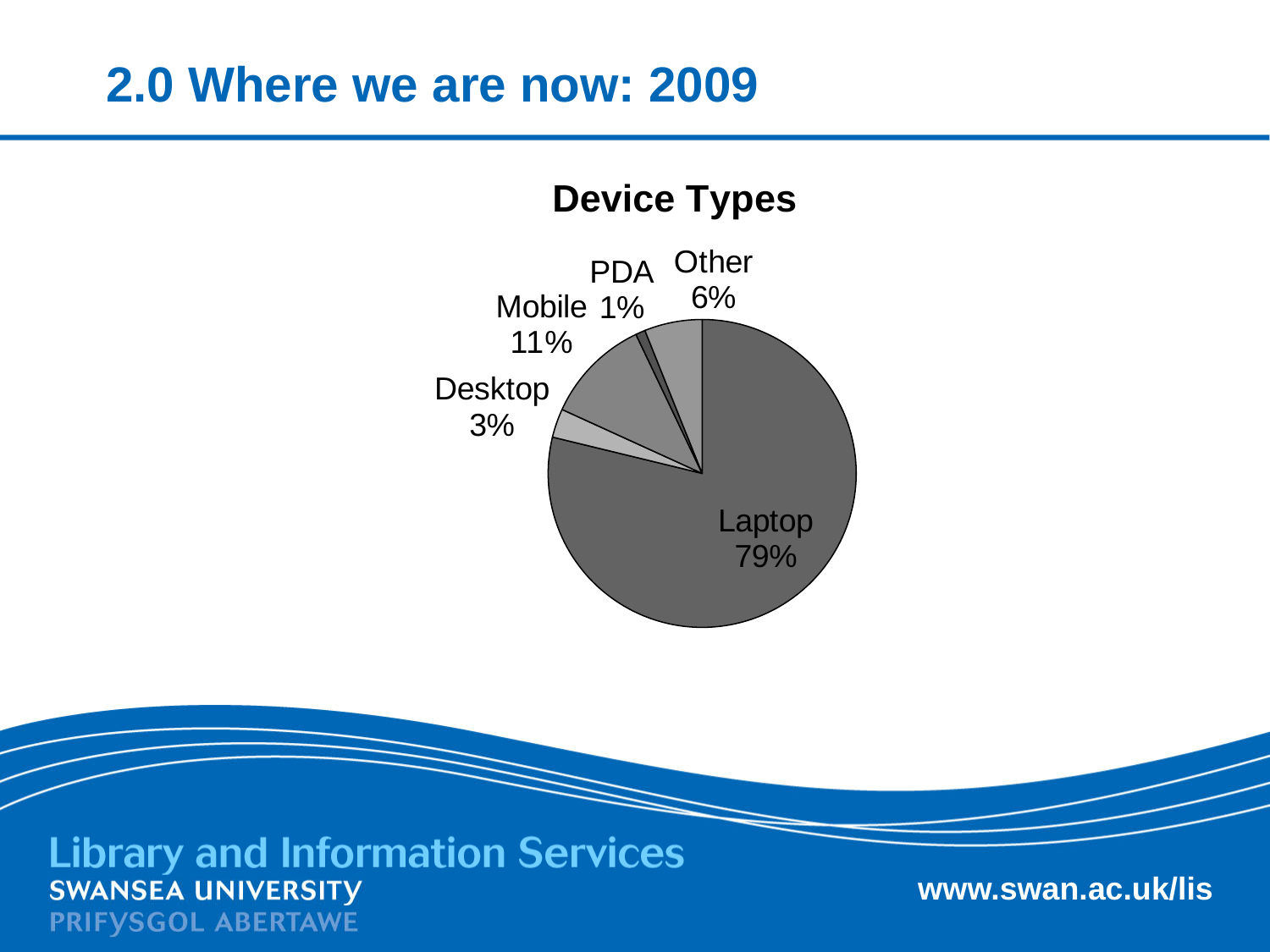
What is the difference between the Laptop and Mobile shares? 68% How many device types are shown in the pie chart? 5 What is the value shown for PDA? 1% Which device type has the largest slice? Laptop What share of the pie does Laptop account for? 79% What is the value shown for Desktop? 3% What is the title of the chart? Device Types What is the value shown for Other? 6% What kind of chart is shown on the slide? Pie chart Which is larger, the Other slice or the Desktop slice? Other What is the value shown for Mobile? 11% Which device type has the smallest slice? PDA